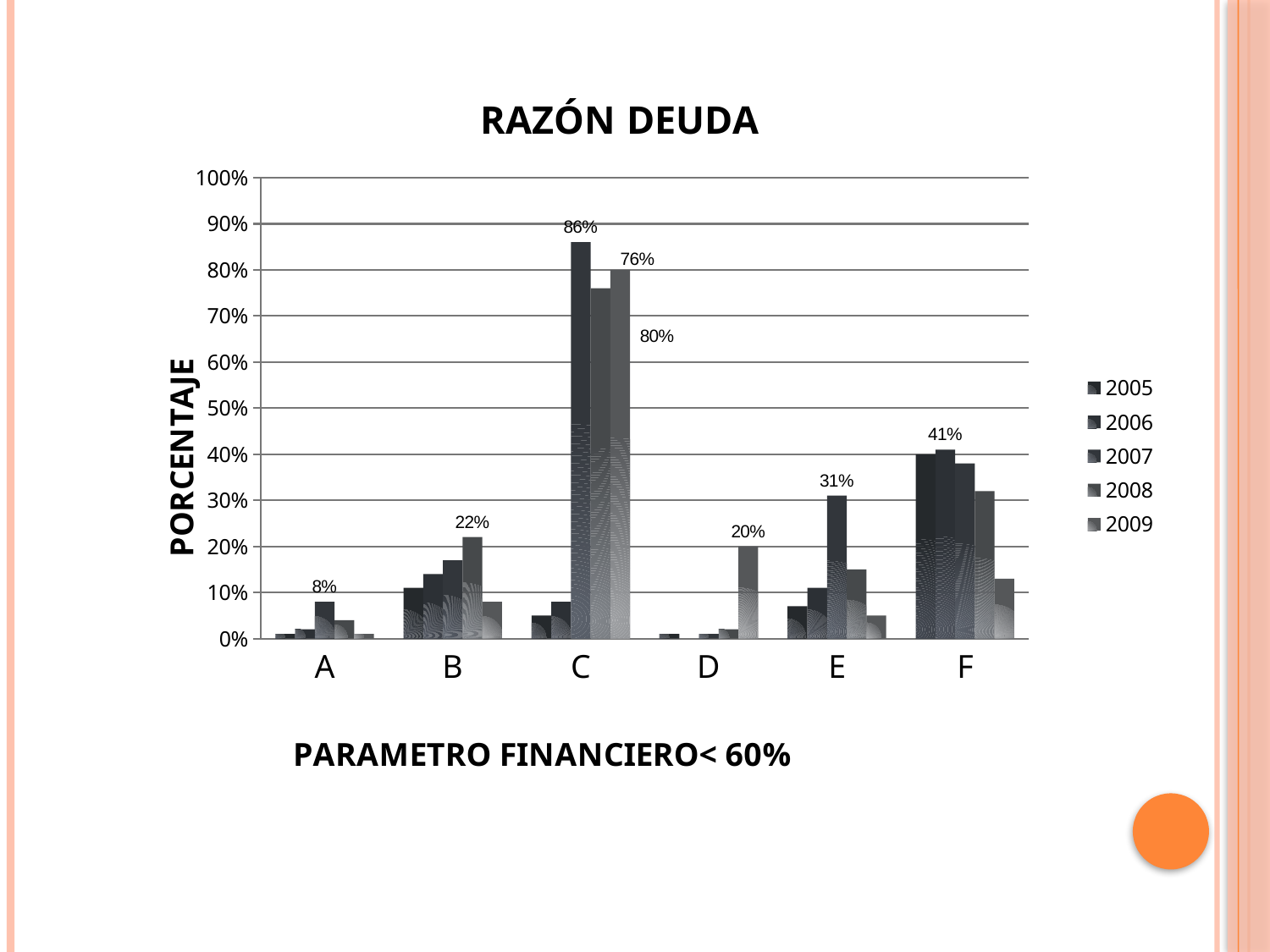
What is the value labelled for category A? 8% Is the 2005 value for category F greater or less than 30%? greater What is the value labelled for category D? 20% What is the highest labelled value for category E? 31% Which category has the tallest bar in the chart? C How many series does the legend list? 5 What is the difference between the labelled values 86% and 76% in category C? 10% What is the highest labelled value for category C? 86% How many categories are shown on the x axis? 6 What is the highest labelled value for category B? 22% What is the title of the vertical axis? PORCENTAJE What type of chart is shown on the slide? Bar chart